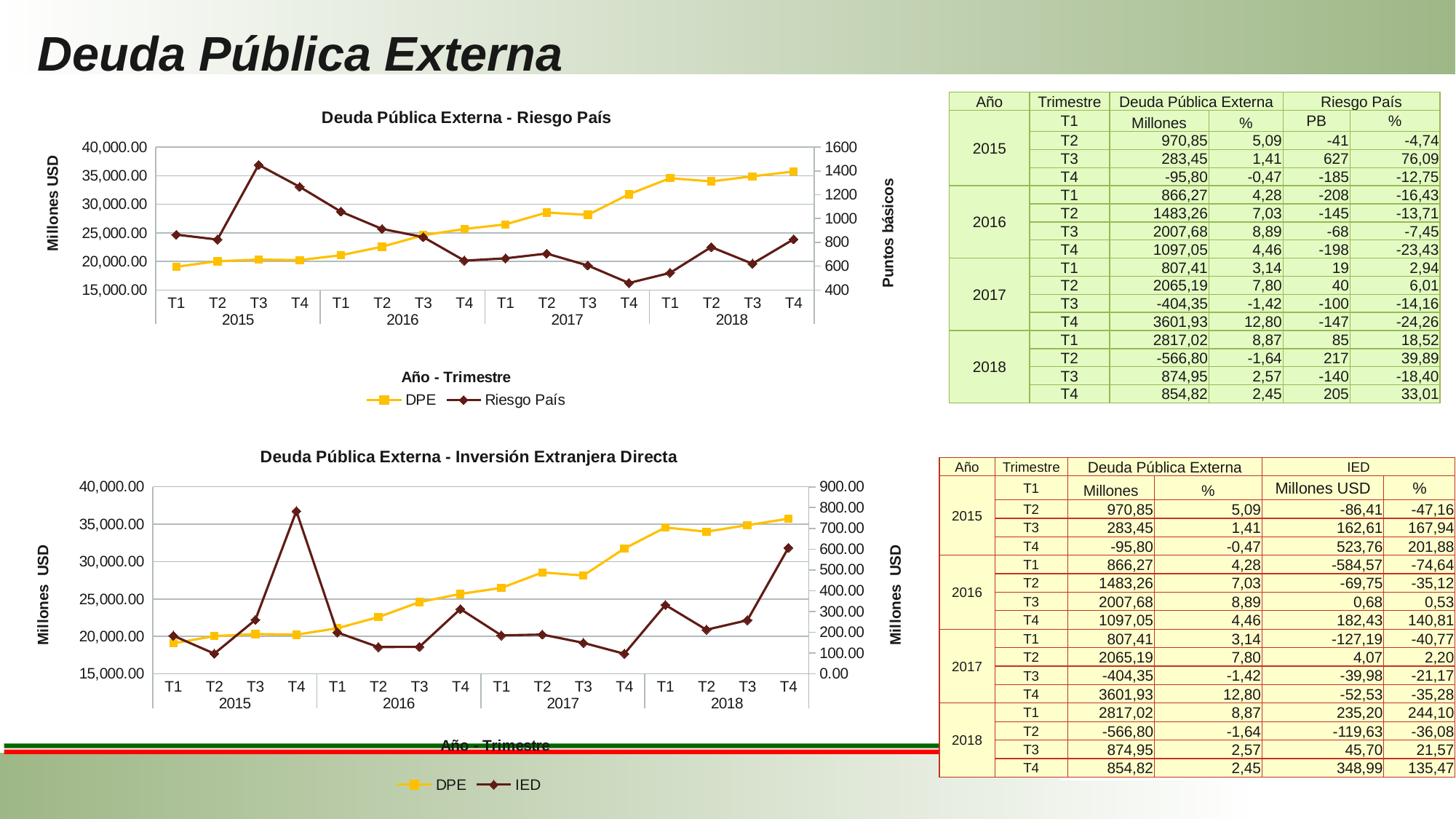
What kind of chart is the 'Deuda Pública Externa - Riesgo País' chart? Line chart In the 'Deuda Pública Externa - Riesgo País' chart, is the DPE value for 2015 T1 greater or less than 20,000.00? less In the 'Deuda Pública Externa - Riesgo País' chart, does the DPE series generally rise or fall from 2015 T1 to 2018 T4? Rise In the 'Deuda Pública Externa - Inversión Extranjera Directa' chart, is the IED value for 2015 T4 greater or less than 600.00? greater In the 'Deuda Pública Externa - Riesgo País' chart, is the Riesgo País value for 2015 T3 greater or less than 1200? greater In the 'Deuda Pública Externa - Riesgo País' chart, at which year and quarter does the Riesgo País series reach its lowest value? 2017 T4 In the 'Deuda Pública Externa - Riesgo País' chart, at which year and quarter does the Riesgo País series reach its highest value? 2015 T3 In the 'Deuda Pública Externa - Inversión Extranjera Directa' chart, at which year and quarter does the IED series reach its highest value? 2015 T4 How many quarterly points are plotted along the x axis of the 'Deuda Pública Externa - Riesgo País' chart? 16 What is the title of the right-hand vertical axis of the 'Deuda Pública Externa - Riesgo País' chart? Puntos básicos How many series does the legend of the 'Deuda Pública Externa - Riesgo País' chart list? 2